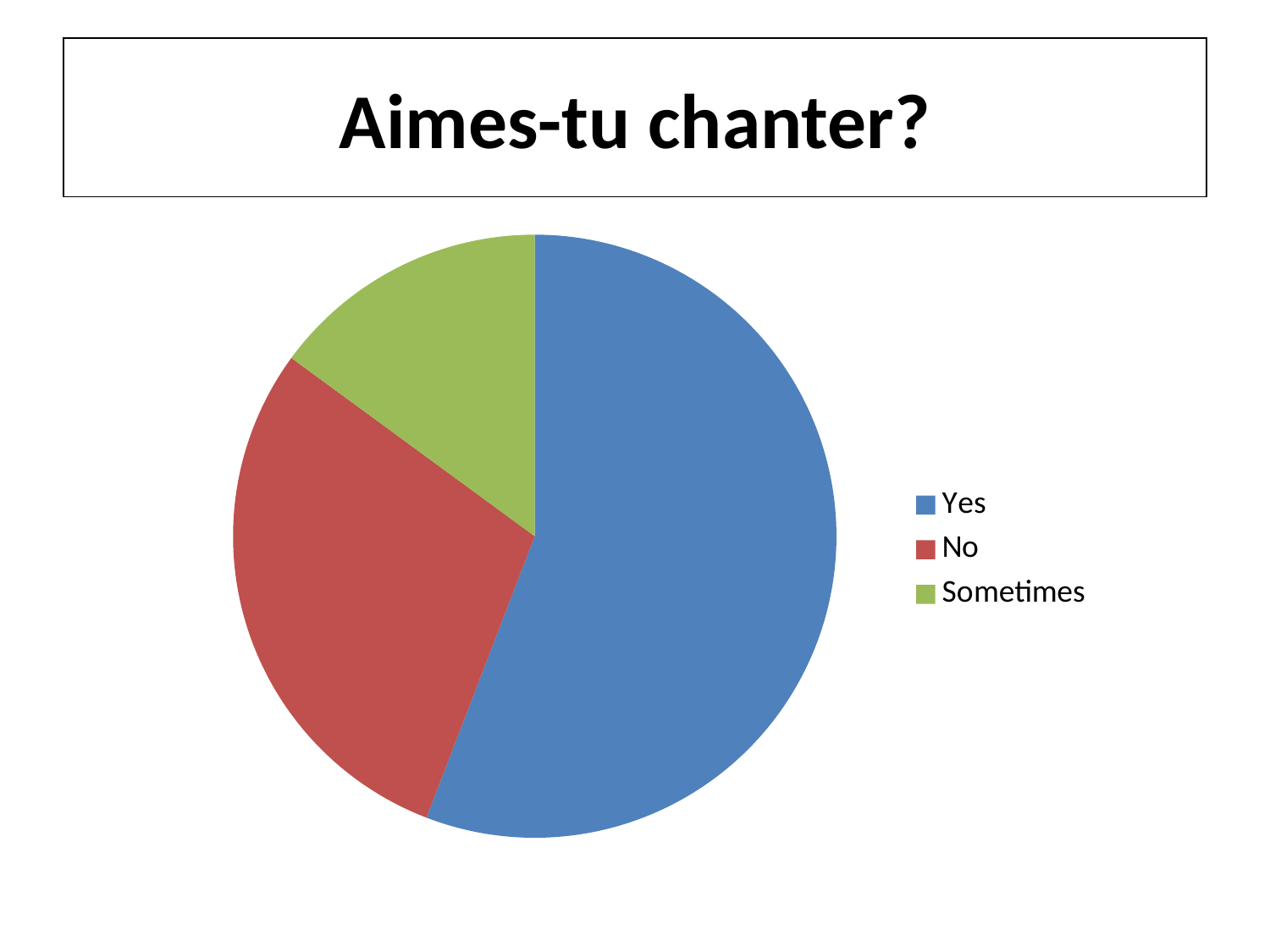
Which category has the largest slice of the pie? Yes Which category has the smallest slice of the pie? Sometimes Which slice is larger, Yes or No? Yes What is the title of the chart on the slide? Aimes-tu chanter? How many slices does the pie chart have? 3 Which slice is larger, No or Sometimes? No How many entries does the legend list? 3 What kind of chart is shown on the slide? pie chart What colour is the slice for Sometimes? green Does the Yes slice take up more or less than half of the pie? more Which slice is smaller, Yes or Sometimes? Sometimes